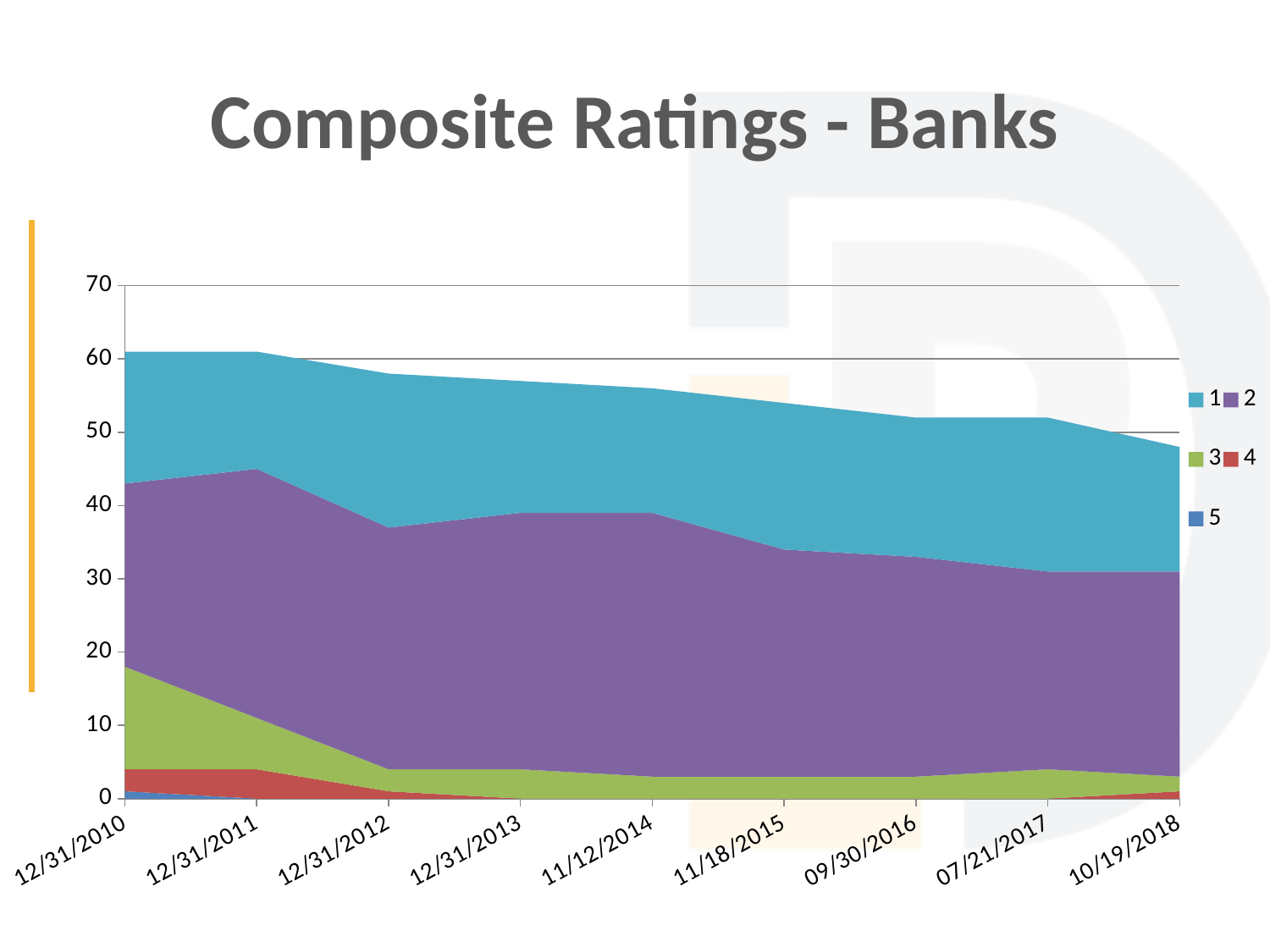
What kind of chart is shown on the slide? Stacked area chart Which date has the lowest stacked total? 10/19/2018 What is the title of the chart? Composite Ratings - Banks Does the stacked total rise or fall from 12/31/2010 to 10/19/2018? fall How many dates are shown along the x axis? 9 Is the stacked total for 12/31/2012 greater or less than 60? less Is the stacked total for 12/31/2010 greater or less than 60? greater Is the stacked total for 10/19/2018 greater or less than 50? less Which has the larger stacked total, 12/31/2010 or 10/19/2018? 12/31/2010 How many series does the legend list? 5 Which colour represents series 2 in the legend? Purple